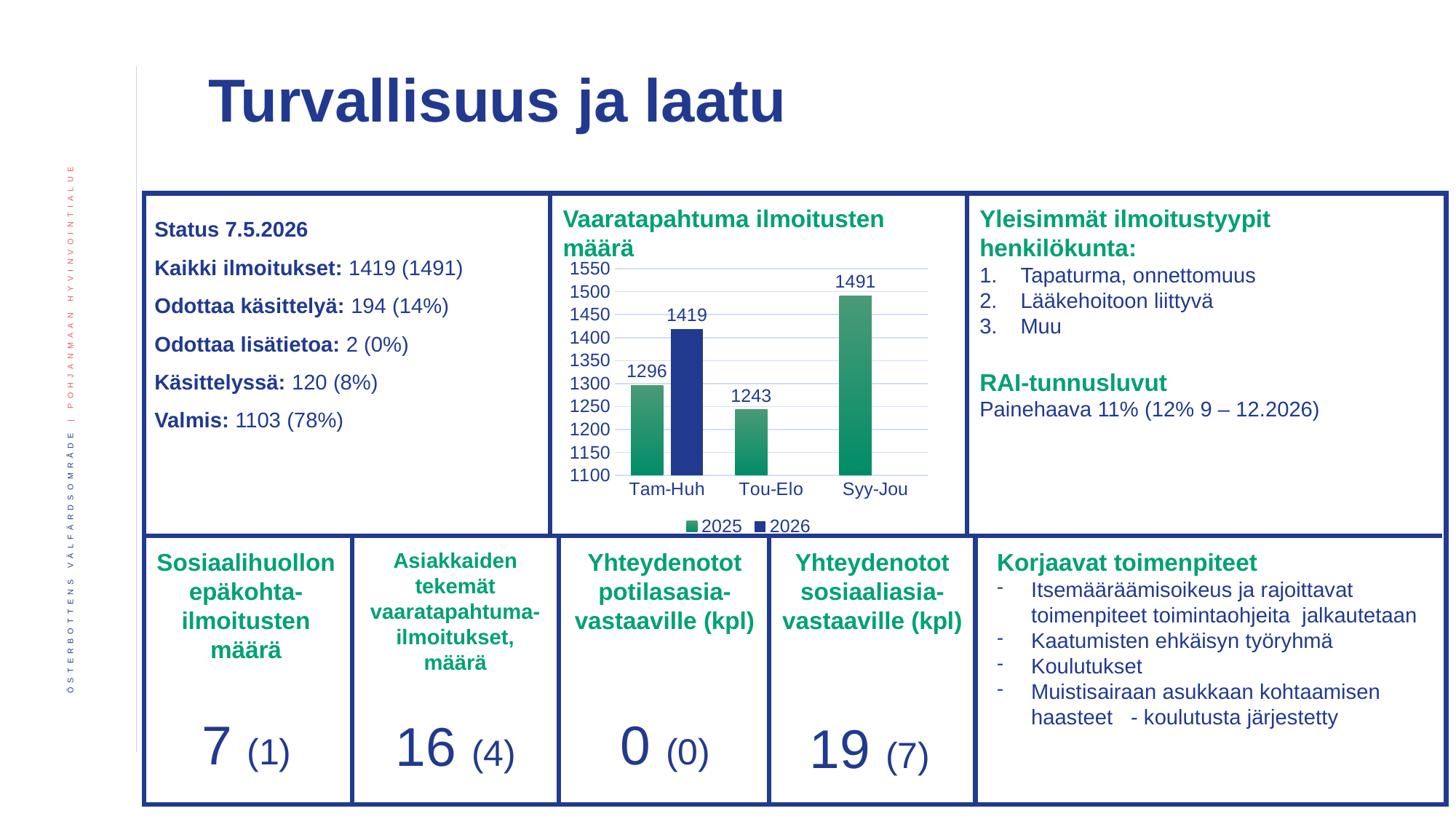
What type of chart is shown on the slide? Bar chart What is the difference between the 2025 values for Syy-Jou and Tou-Elo? 248 What is the value for 2025 in Syy-Jou? 1491 Which category has the lowest value for the 2025 series? Tou-Elo What is the difference between the 2026 and 2025 values in Tam-Huh? 123 How many categories are shown on the x axis of the chart? 3 Which category has the highest value for the 2025 series? Syy-Jou What is the value for 2025 in Tam-Huh? 1296 What is the value for 2026 in Tam-Huh? 1419 What is the value for 2025 in Tou-Elo? 1243 How many series does the chart legend list? 2 Which is larger in Tam-Huh, the 2025 value or the 2026 value? 2026